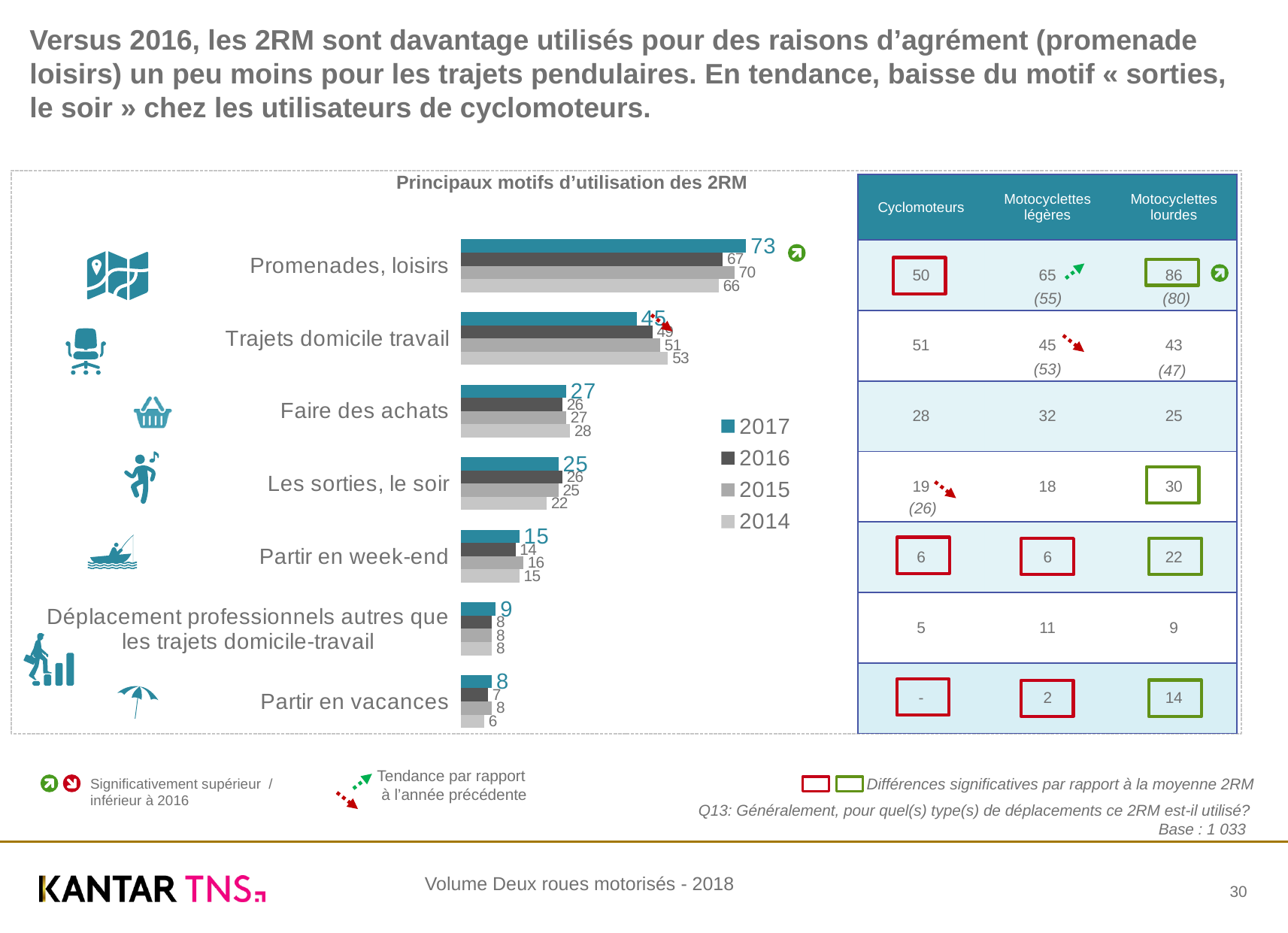
For "Trajets domicile travail", which year has the larger value, 2017 or 2014? 2014 How many categories are shown in the bar chart? 7 What is the 2015 value for "Partir en week-end"? 16 What is the 2017 value for "Promenades, loisirs"? 73 From 2014 to 2017, does the value for "Trajets domicile travail" rise or fall? Fall Which category has the lowest 2017 value? Partir en vacances What is the title of the bar chart? Principaux motifs d’utilisation des 2RM What is the difference between the 2017 and 2016 values for "Promenades, loisirs"? 6 What kind of chart is shown on the slide? Bar chart Which category has the highest 2017 value? Promenades, loisirs What is the 2014 value for "Trajets domicile travail"? 53 How many series does the legend list? 4